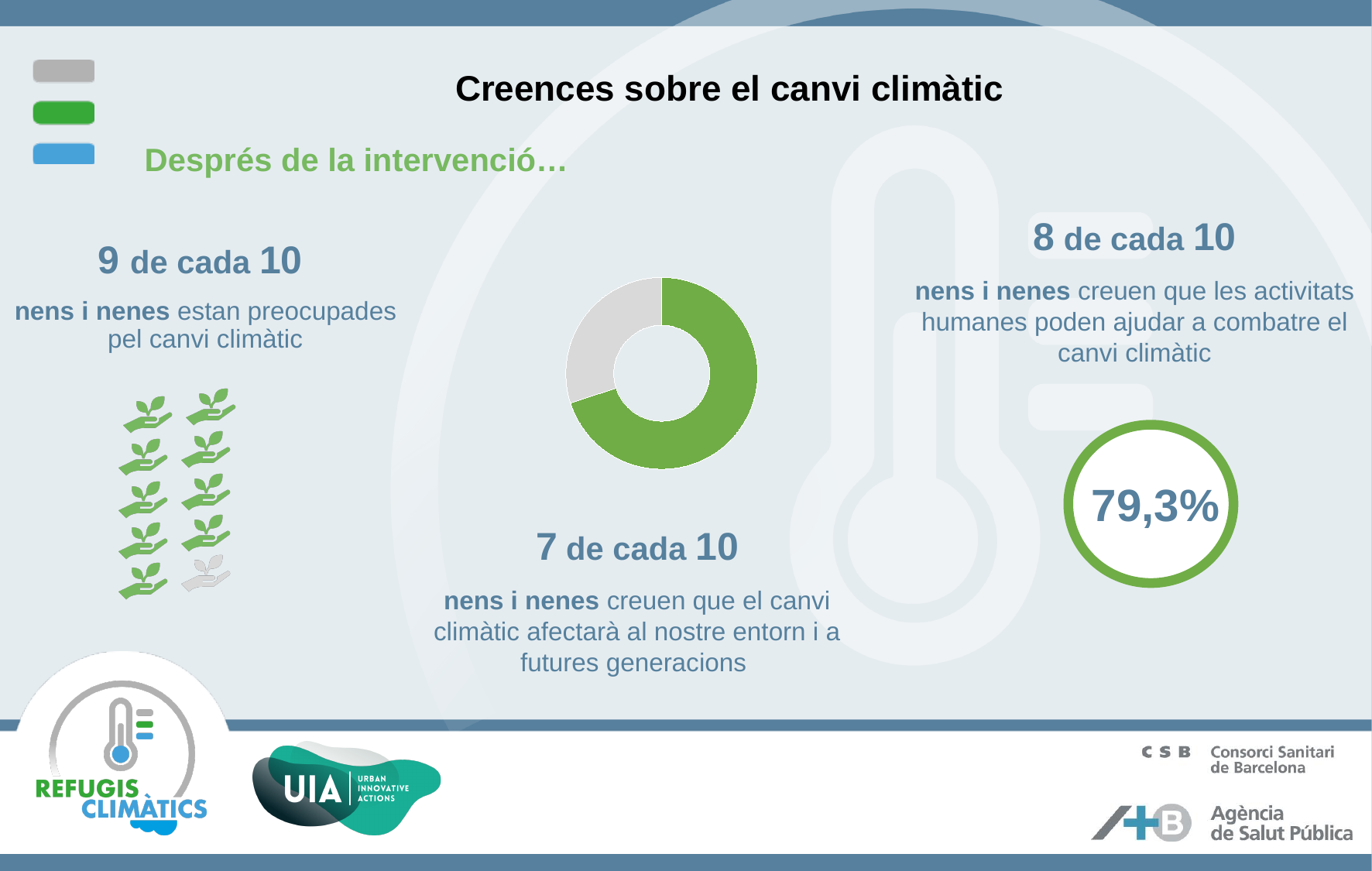
In the donut chart, which slice is larger, the green one or the grey one? The green one In the pictogram of hands on the left of the slide, how many hands are coloured green? 9 Does the grey slice of the donut chart cover more or less than half of the ring? Less How many slices does the donut chart in the centre of the slide have? 2 Does the green slice of the donut chart cover more or less than half of the ring? More What is the title of the slide containing the donut chart? Creences sobre el canvi climàtic What kind of chart is shown in the centre of the slide? Donut (pie) chart What statistic is printed directly below the donut chart? 7 de cada 10 In the pictogram of hands on the left of the slide, how many hands are shown in total? 10 What percentage is printed inside the green circle on the right of the slide? 79,3%